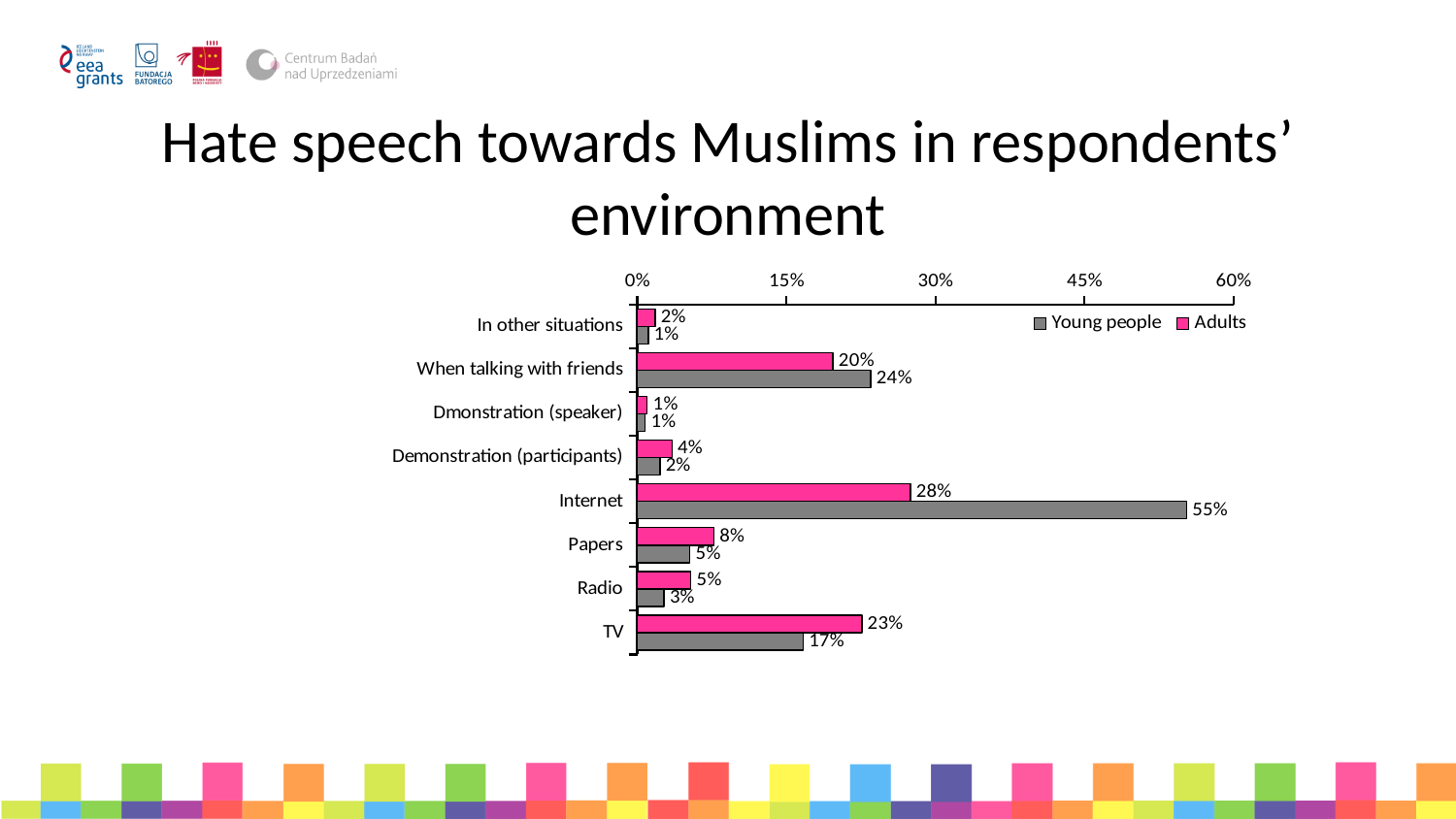
Which category has the highest value for Adults? Internet Which category has the highest value for Young people? Internet Which colour represents the Adults series in the legend? pink How many categories are shown on the chart? 8 Which is larger for TV: the Young people value or the Adults value? Adults How many series does the legend list? 2 What kind of chart is shown on the slide? bar chart What is the value for Adults for TV? 23% What is the difference between the Adults and Young people values for Papers? 3% What is the value for Adults for When talking with friends? 20% What is the difference between the Young people and Adults values for Internet? 27% What is the value for Young people for Internet? 55%